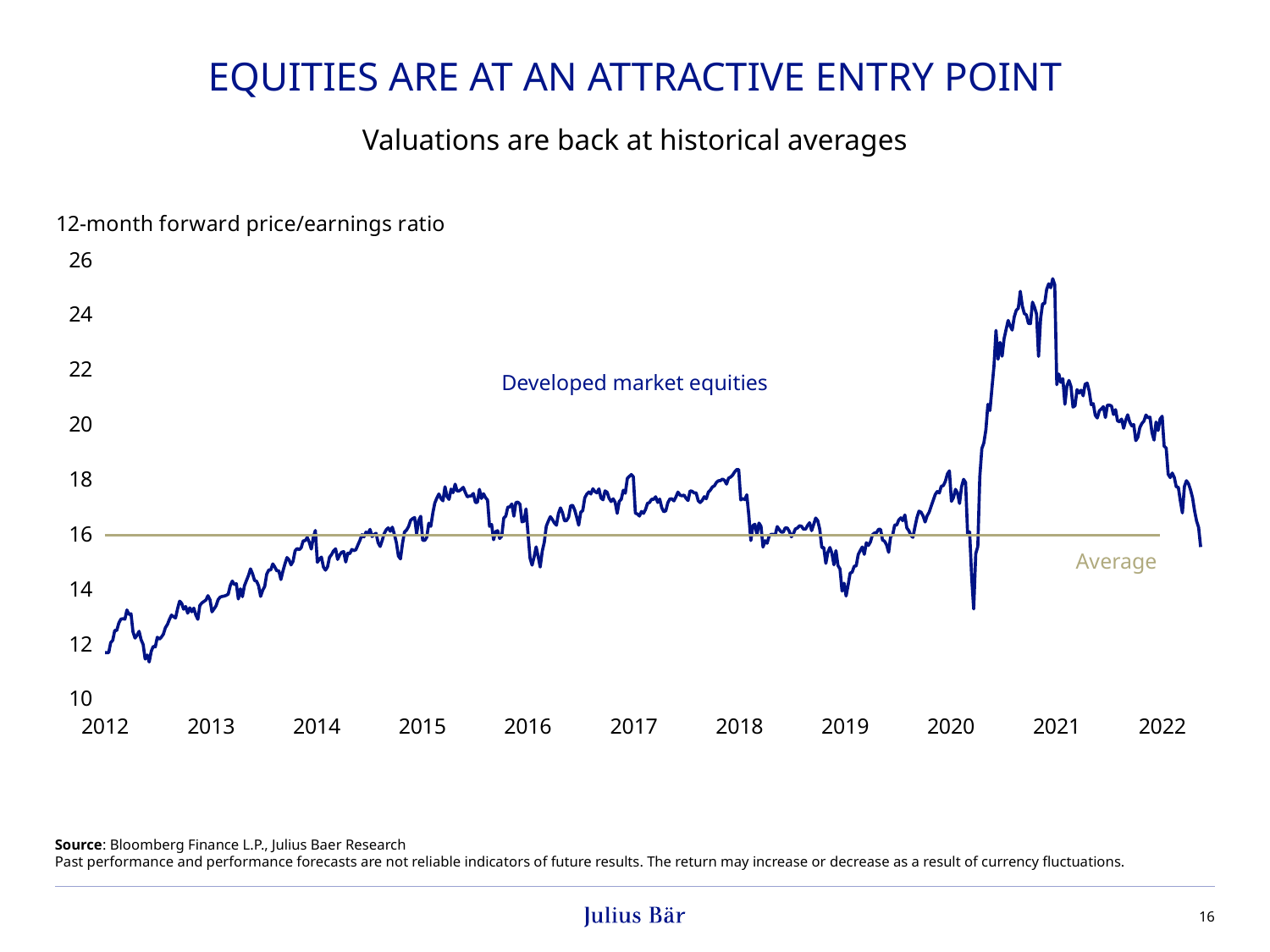
What is the y-axis measuring, according to the label above the chart? 12-month forward price/earnings ratio In which year does the Developed market equities line reach its lowest point? 2012 How many lines are plotted on the chart? 2 What value does the Average line sit at on the y axis? 16 How many year labels are shown on the x axis? 11 Is the value for Developed market equities at the start of 2012 greater or less than 14? less What kind of chart is shown on the slide? Line chart Is the value for Developed market equities at the start of 2017 greater or less than 16? greater Does the Developed market equities line rise or fall between 2021 and 2022? Fall Is the value for Developed market equities at the start of 2019 greater or less than 16? less